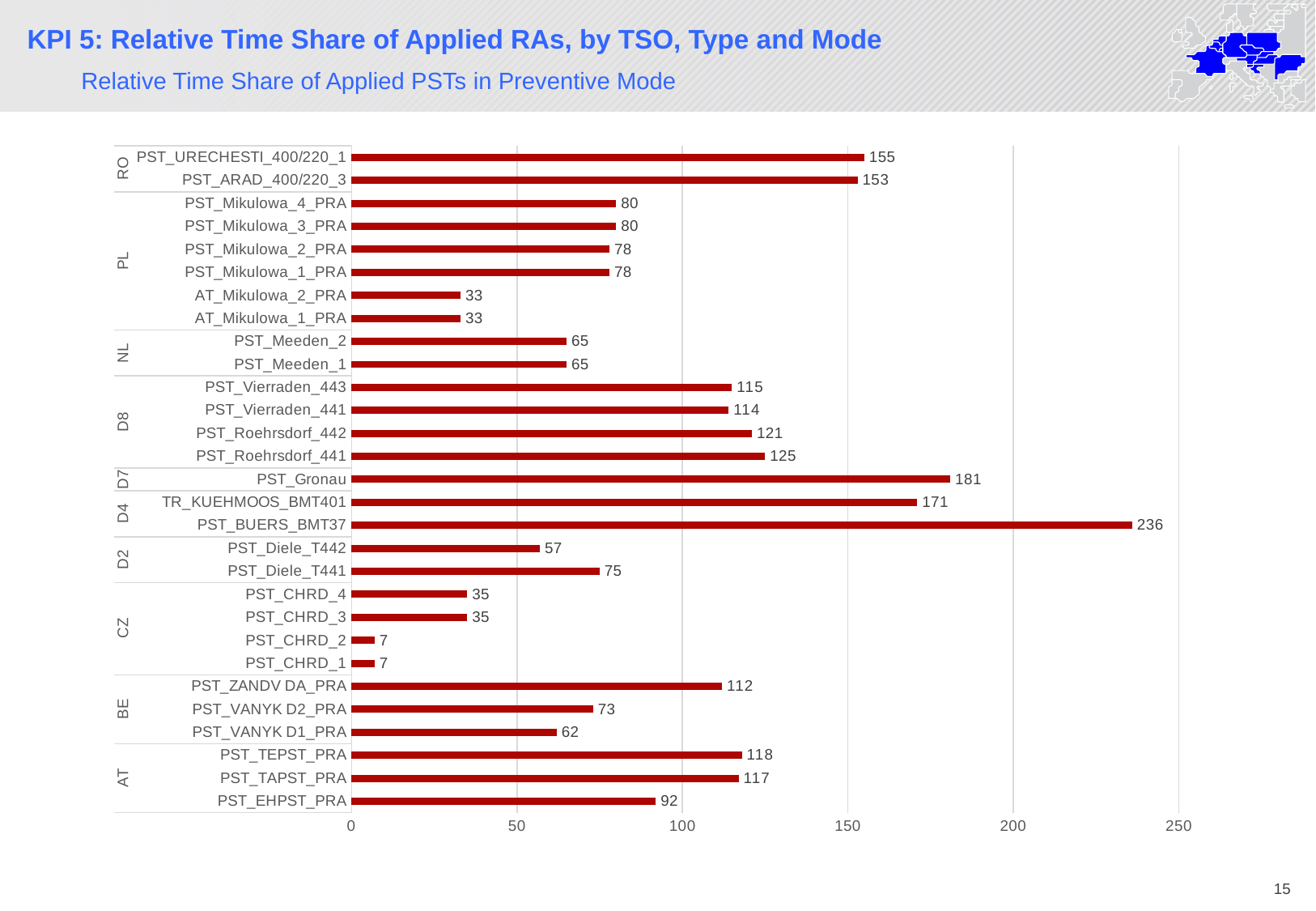
Which category has the highest value? PST_BUERS_BMT37 What is the value for PST_ZANDV DA_PRA? 112 What is the value for PST_Roehrsdorf_441? 125 What is the value for PST_Diele_T442? 57 What is the subtitle of the chart on the slide? Relative Time Share of Applied PSTs in Preventive Mode What is the difference between the values for PST_BUERS_BMT37 and TR_KUEHMOOS_BMT401? 65 What is the value for PST_Gronau? 181 What kind of chart is shown on the slide? Bar chart Which is larger, the value for PST_Vierraden_443 or the value for PST_Meeden_2? PST_Vierraden_443 Which is larger, the value for PST_TEPST_PRA or the value for PST_EHPST_PRA? PST_TEPST_PRA How many categories (bars) are shown in the chart? 29 What is the difference between the values for PST_URECHESTI_400/220_1 and PST_ARAD_400/220_3? 2